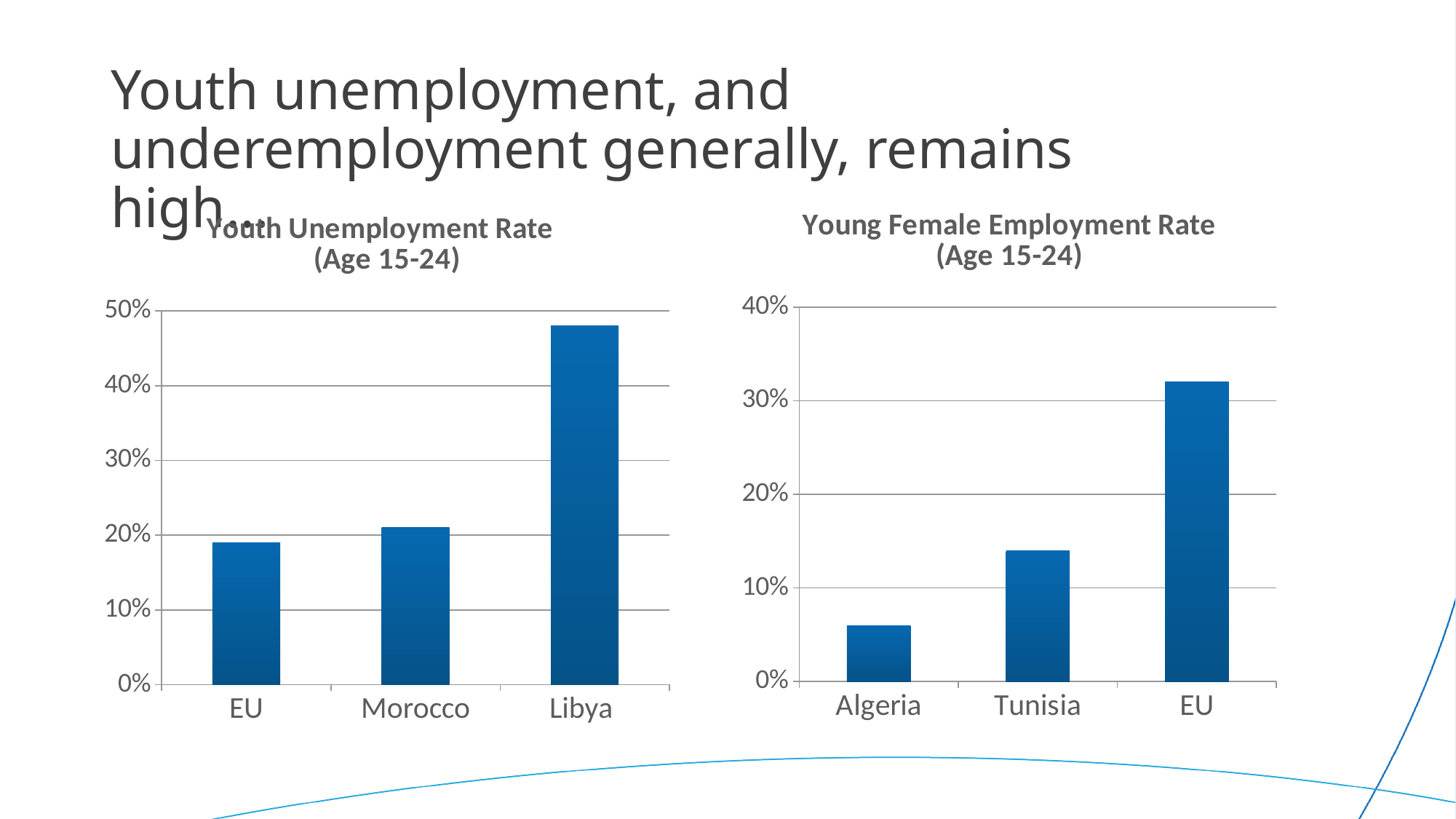
On the Youth Unemployment Rate (Age 15-24) chart, is the value for Morocco greater or less than 30%? less What kind of chart is the Youth Unemployment Rate (Age 15-24) chart? bar chart On the Young Female Employment Rate (Age 15-24) chart, do the values rise or fall from left to right across the categories? rise On the Youth Unemployment Rate (Age 15-24) chart, is the value for Libya greater or less than 40%? greater On the Young Female Employment Rate (Age 15-24) chart, is the value for Algeria greater or less than 10%? less On the Young Female Employment Rate (Age 15-24) chart, which country has the lowest young female employment rate? Algeria On the Young Female Employment Rate (Age 15-24) chart, which is larger, the value for Tunisia or the value for Algeria? Tunisia On the Youth Unemployment Rate (Age 15-24) chart, which category has the lowest value? EU On the Youth Unemployment Rate (Age 15-24) chart, how many countries are shown? 3 On the Youth Unemployment Rate (Age 15-24) chart, which country has the highest youth unemployment rate? Libya On the Young Female Employment Rate (Age 15-24) chart, which category has the highest value? EU